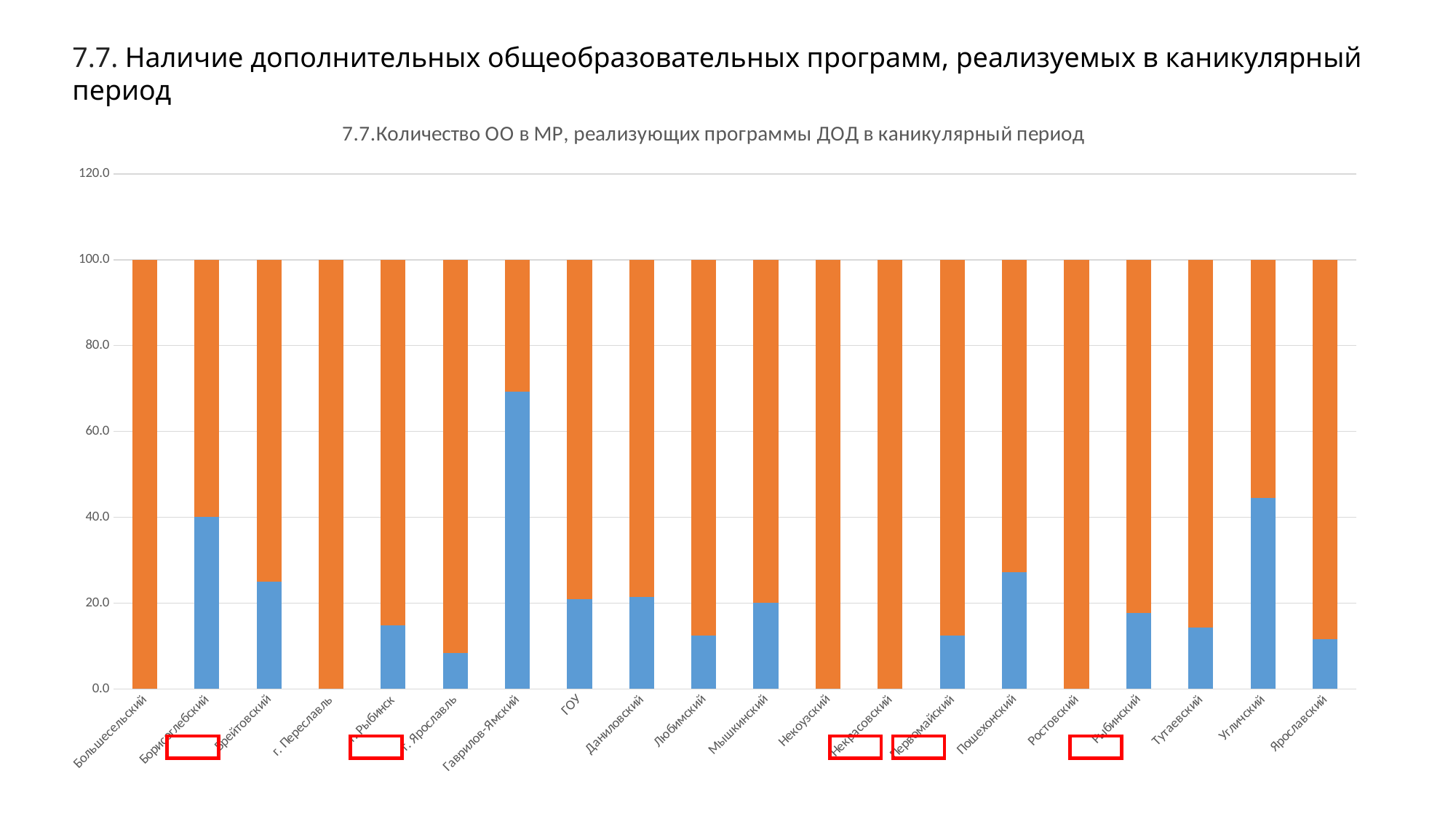
What is the title of the chart? 7.7.Количество ОО в МР, реализующих программы ДОД в каникулярный период What type of chart is shown on the slide? Stacked bar chart Which category has the largest blue segment? Гаврилов-Ямский Is the blue segment for Угличский greater or less than 40.0? greater Is the blue segment for Пошехонский greater or less than 20.0? greater Is the blue segment for Рыбинск greater or less than 20.0? less How many bars consist entirely of the orange segment with no blue segment? 5 Which has the larger blue segment, Угличский or Гаврилов-Ямский? Гаврилов-Ямский How many categories (bars) are shown on the x axis? 20 What is the total height of the stacked bar for Большесельский? 100.0 Which has the larger blue segment, Борисоглебский or Брейтовский? Борисоглебский